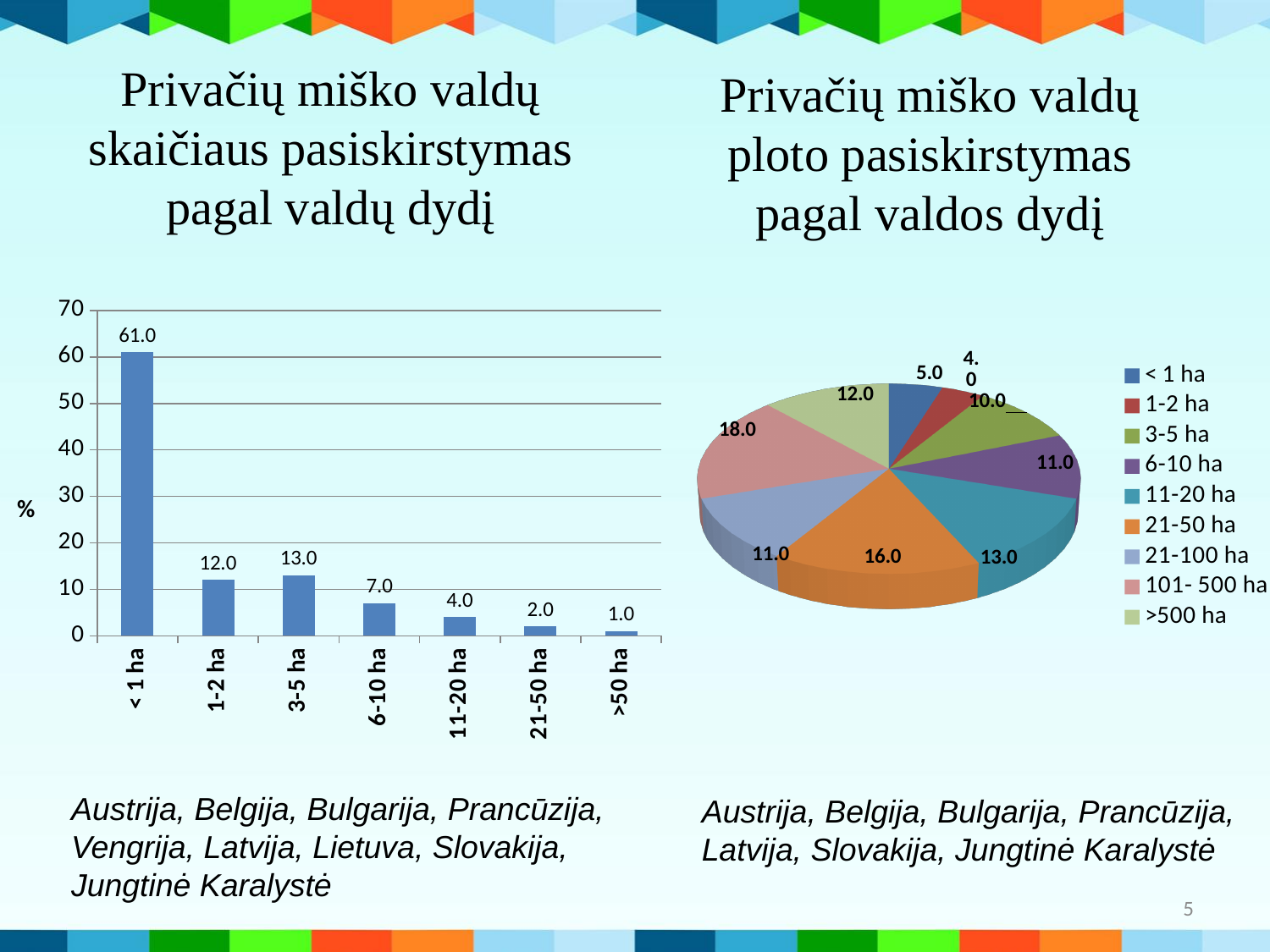
In the right pie chart, what is the value for the 21-50 ha slice? 16.0 In the left bar chart, what is the difference between the values for 3-5 ha and 1-2 ha? 1.0 In the right pie chart (Privačių miško valdų ploto pasiskirstymas pagal valdos dydį), what is the value for the 101- 500 ha slice? 18.0 In the left bar chart, what is the value for the 6-10 ha category? 7.0 In the left bar chart (Privačių miško valdų skaičiaus pasiskirstymas pagal valdų dydį), what is the value for the < 1 ha category? 61.0 What type of chart is the left chart on the slide? Bar chart In the left bar chart, which category has the lowest value? >50 ha How many entries does the legend of the right pie chart list? 9 In the left bar chart, how many categories are shown on the x axis? 7 In the right pie chart, which slice is larger: 11-20 ha or >500 ha? 11-20 ha In the left bar chart, which category has the highest value? < 1 ha In the left bar chart, do the values generally rise or fall from left to right along the x axis? Fall